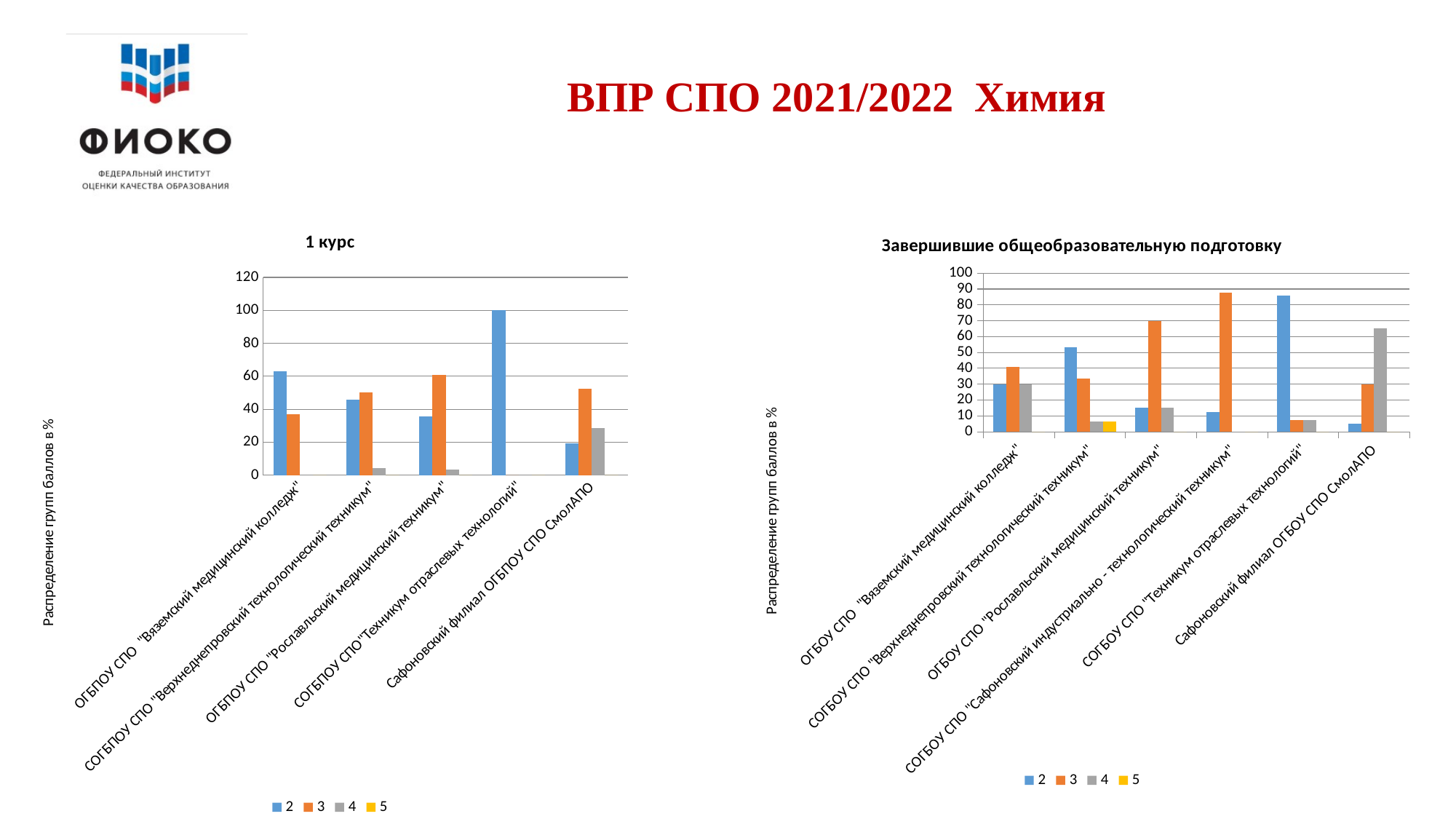
In the "Завершившие общеобразовательную подготовку" chart, how many institutions are shown on the x axis? 6 In the "Завершившие общеобразовательную подготовку" chart, is the value of series 2 for СОГБОУ СПО "Техникум отраслевых технологий" greater or less than 80? greater In the "1 курс" chart, which institution has the highest bar for series 2? СОГБПОУ СПО "Техникум отраслевых технологий" What is the title of the chart on the right side of the slide? Завершившие общеобразовательную подготовку In the "Завершившие общеобразовательную подготовку" chart, which institution has the highest bar for series 3? СОГБОУ СПО "Сафоновский индустриально - технологический техникум" In the "1 курс" chart, what is the value of series 2 for СОГБПОУ СПО "Техникум отраслевых технологий"? 100 How many series does the legend of the "1 курс" chart list? 4 In the "Завершившие общеобразовательную подготовку" chart, which institution has the lowest bar for series 2? Сафоновский филиал ОГБОУ СПО СмолАПО In the "1 курс" chart, how many institutions are shown on the x axis? 5 In the "1 курс" chart, is the value of series 3 for ОГБПОУ СПО "Рославльский медицинский техникум" greater or less than 50? greater In the "Завершившие общеобразовательную подготовку" chart, for Сафоновский филиал ОГБОУ СПО СмолАПО, which series has the larger value: 3 or 4? 4 What kind of chart is the "1 курс" chart on the left? Bar chart